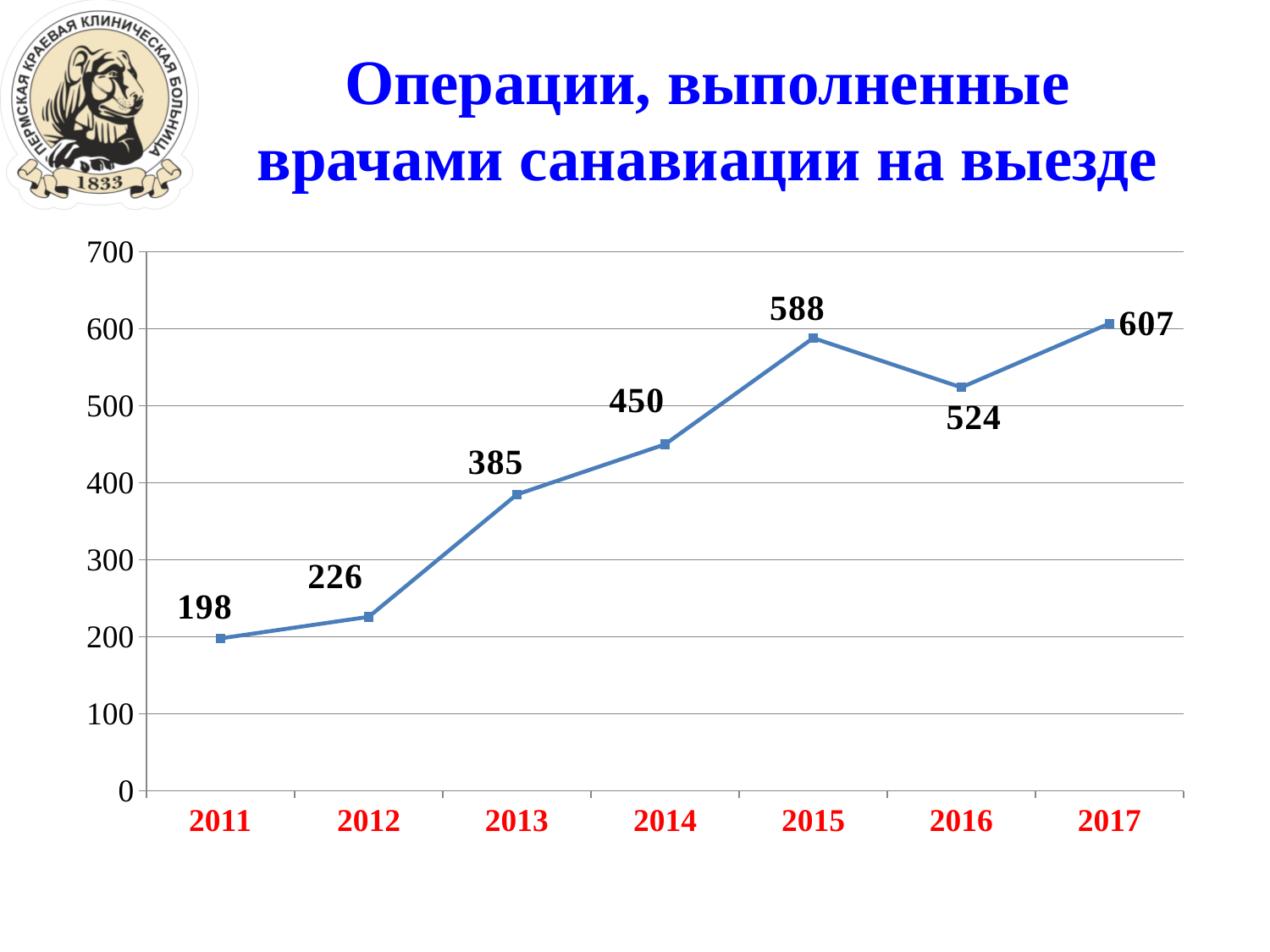
Which is larger, the value for 2015 or the value for 2016? 2015 What kind of chart is shown on the slide? line chart What is the difference between the values for 2017 and 2011? 409 What is the difference between the values for 2015 and 2014? 138 Do the values generally rise or fall from 2011 to 2017? rise What is the value for 2016? 524 Which year has the highest value? 2017 What is the title of the chart? Операции, выполненные врачами санавиации на выезде What is the value for 2013? 385 Which year has the lowest value? 2011 How many years are plotted on the chart? 7 Is the value for 2014 greater or less than 400? greater